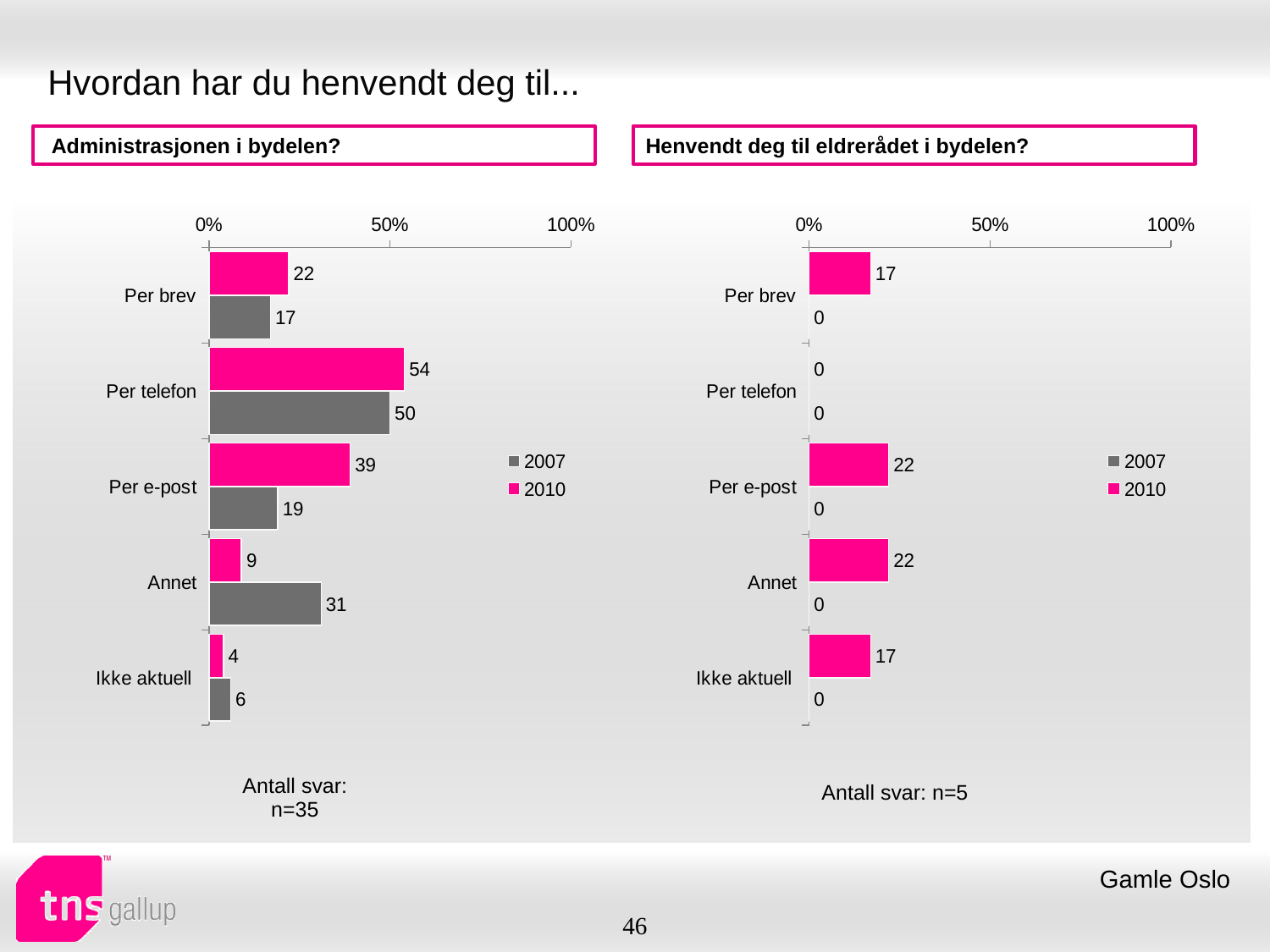
In the chart titled "Administrasjonen i bydelen?", which category has the highest value for 2010? Per telefon In the chart titled "Henvendt deg til eldrerådet i bydelen?", what is the value for Per brev in 2007? 0 In the chart titled "Henvendt deg til eldrerådet i bydelen?", what is the value for Per e-post in 2010? 22 In the chart titled "Henvendt deg til eldrerådet i bydelen?", how many series does the legend list? 2 In the chart titled "Administrasjonen i bydelen?", what is the value for Annet in 2007? 31 In the chart titled "Administrasjonen i bydelen?", what is the difference between the 2010 and 2007 values for Per e-post? 20 What kind of chart is the chart titled "Administrasjonen i bydelen?"? Bar chart In the chart titled "Henvendt deg til eldrerådet i bydelen?", how many categories are shown? 5 In the chart titled "Administrasjonen i bydelen?", which category has the lowest value for 2007? Ikke aktuell In the chart titled "Administrasjonen i bydelen?", what is the value for Per telefon in 2010? 54 In the chart titled "Administrasjonen i bydelen?", which is larger for Annet: the 2007 value or the 2010 value? 2007 In the chart titled "Administrasjonen i bydelen?", is the 2010 value for Per telefon greater or less than 50%? greater